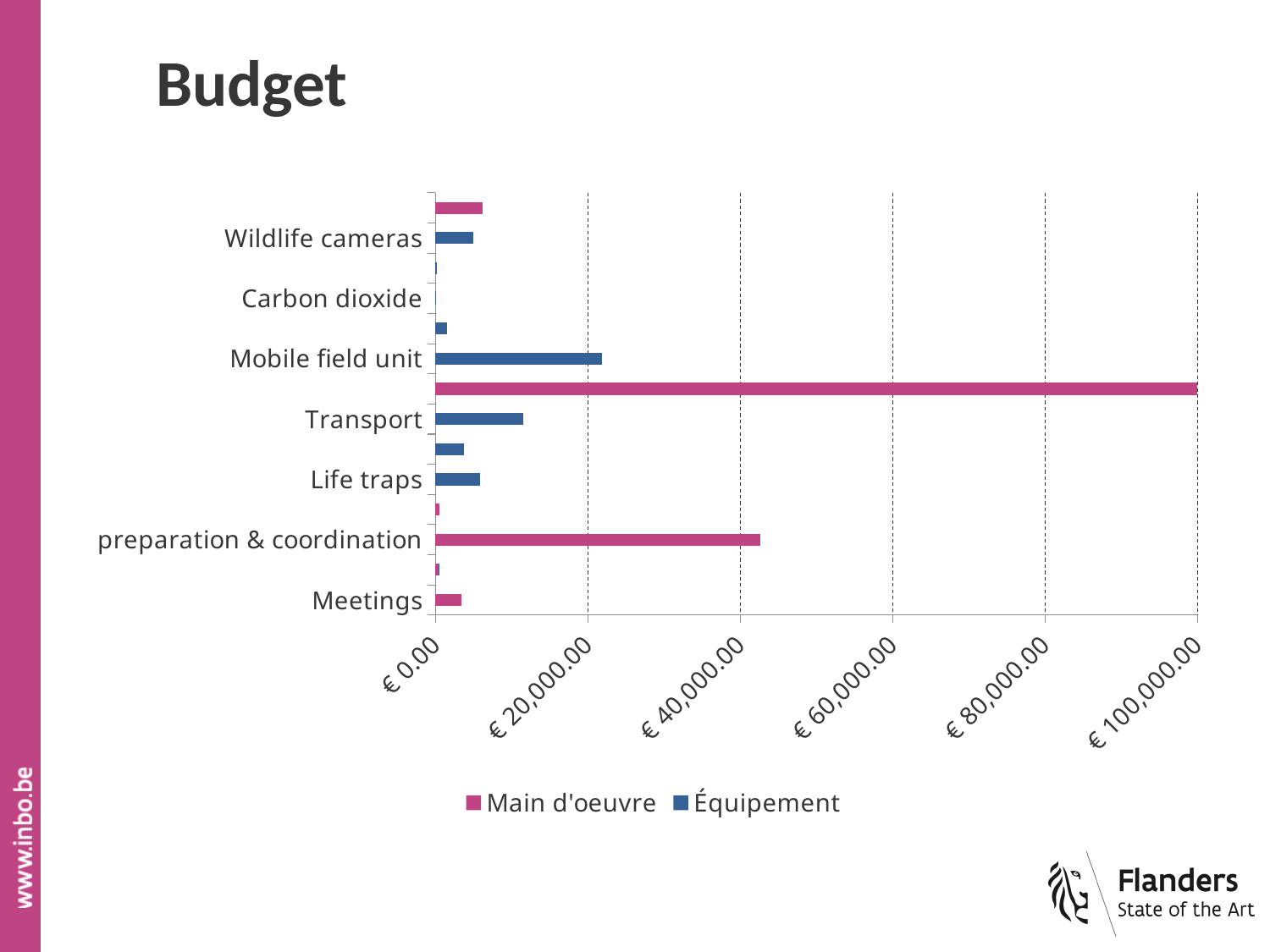
What is the highest value shown on the horizontal axis? € 100,000.00 Which series does the longest bar in the chart belong to? Main d'oeuvre What kind of chart is shown on the slide? bar chart Are the values for Wildlife cameras greater or less than € 20,000.00? less What is the title of the slide containing the chart? Budget Are the values for Life traps greater or less than € 20,000.00? less What are the two series named in the legend? Main d'oeuvre and Équipement Is the largest value for preparation & coordination greater or less than € 60,000.00? less How many categories are labelled on the vertical axis? 7 How many series does the legend list? 2